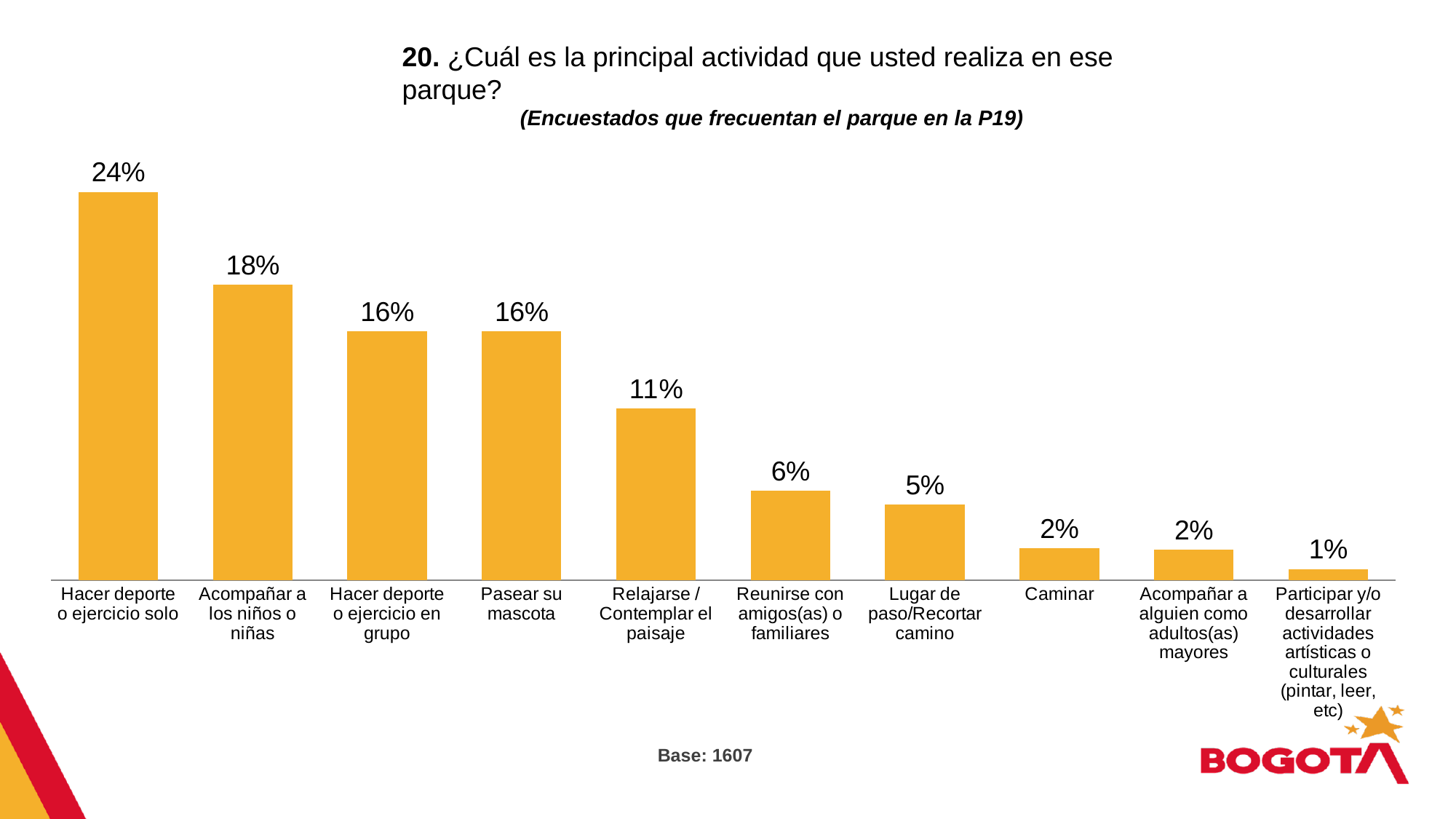
What is the value for "Caminar"? 2% What is the value for "Hacer deporte o ejercicio solo"? 24% What is the difference between "Hacer deporte o ejercicio solo" and "Acompañar a los niños o niñas"? 6% What kind of chart is shown on the slide? Bar chart What is the value for "Pasear su mascota"? 16% How many categories are shown in the chart? 10 What is the value for "Relajarse / Contemplar el paisaje"? 11% Which is larger, "Reunirse con amigos(as) o familiares" or "Lugar de paso/Recortar camino"? Reunirse con amigos(as) o familiares Do the values rise or fall from left to right along the x axis? Fall Which category has the highest value? Hacer deporte o ejercicio solo What is the base (number of respondents) stated below the chart? 1607 Which category has the lowest value? Participar y/o desarrollar actividades artísticas o culturales (pintar, leer, etc)